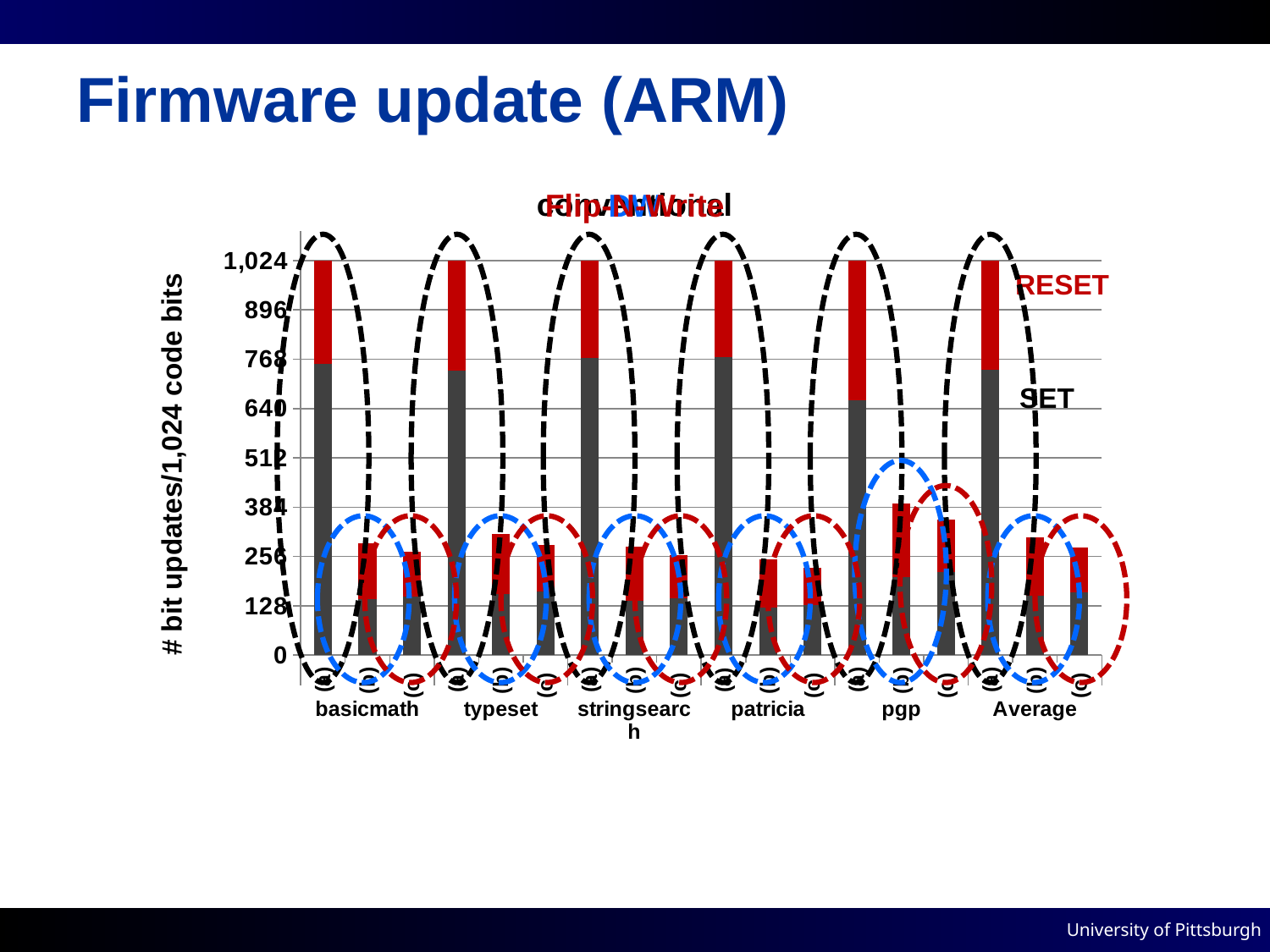
Is the total of the third bar in the pgp group greater or less than 384? less Is the total of the third bar in the patricia group greater or less than 256? less What is the total height of the first (leftmost) bar in the Average group? 1,024 What is the total height of the first (leftmost) bar in the basicmath group? 1,024 Is the total of the second bar in the basicmath group greater or less than 256? greater What kind of chart is shown on the slide? bar chart Which is larger: the total of the second bar in the pgp group or the total of the second bar in the basicmath group? pgp What is the label of the y axis? # bit updates/1,024 code bits How many series does the chart distinguish (RESET and SET)? 2 How many benchmark categories are shown along the x axis? 6 Which colour represents the RESET series? red Among the second bars of each group, which benchmark has the highest total? pgp